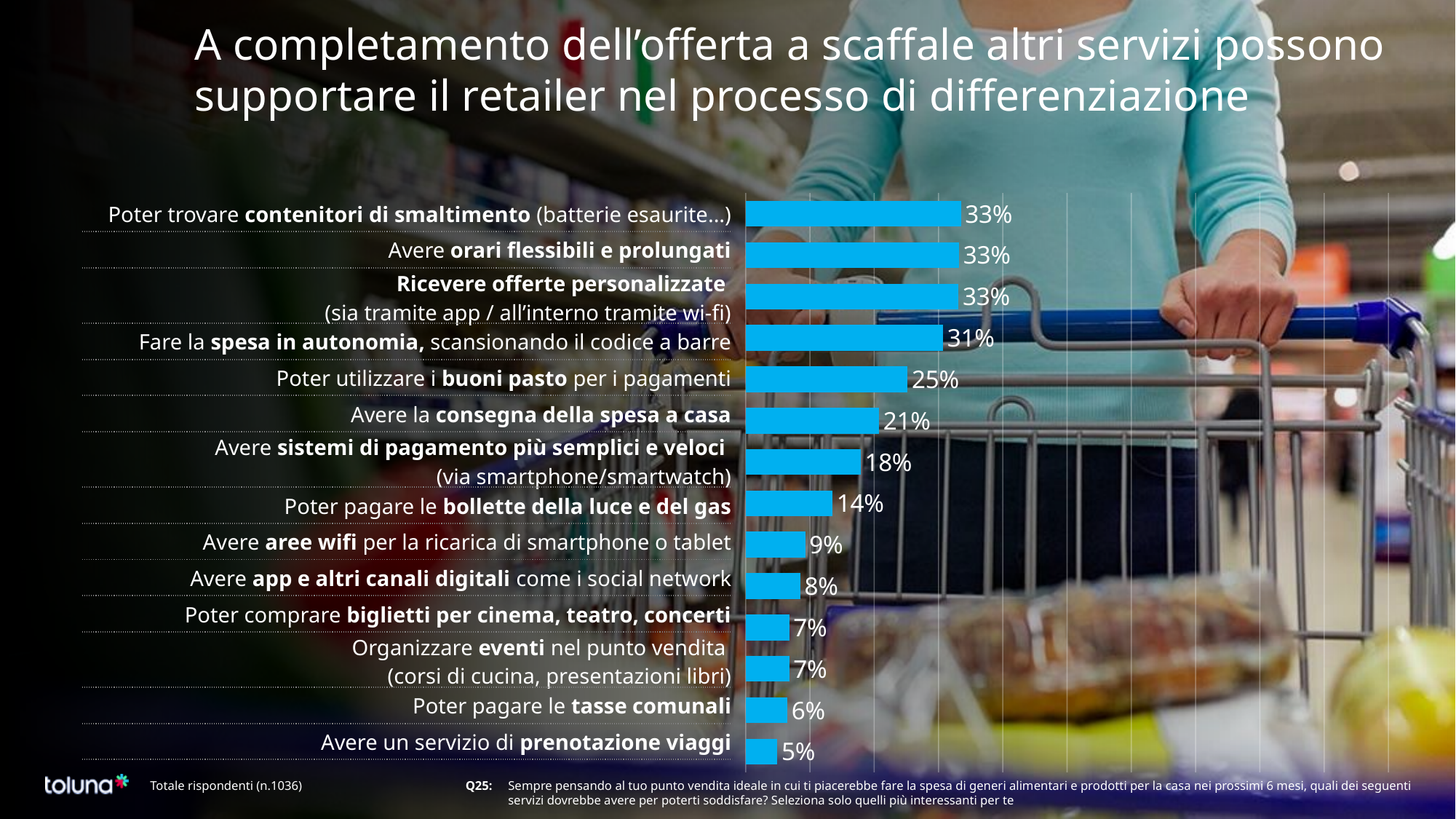
Which service has the lowest percentage in the chart? Avere un servizio di prenotazione viaggi What percentage of respondents chose "Avere la consegna della spesa a casa"? 21% What is the value for "Poter pagare le bollette della luce e del gas"? 14% What is the difference between the values for "Avere orari flessibili e prolungati" and "Poter pagare le tasse comunali"? 27 percentage points What percentage is shown for "Fare la spesa in autonomia, scansionando il codice a barre"? 31% How many services (categories) are shown in the chart? 14 What type of chart is shown on the slide? Bar chart How many services share the top value of 33%? 3 Which has a higher value: "Avere app e altri canali digitali come i social network" or "Avere la consegna della spesa a casa"? Avere la consegna della spesa a casa What is the difference between the values for "Avere sistemi di pagamento più semplici e veloci" and "Avere aree wifi per la ricarica di smartphone o tablet"? 9 percentage points What is the total number of respondents stated on the slide? 1036 What is the value shown for "Poter utilizzare i buoni pasto per i pagamenti"? 25%